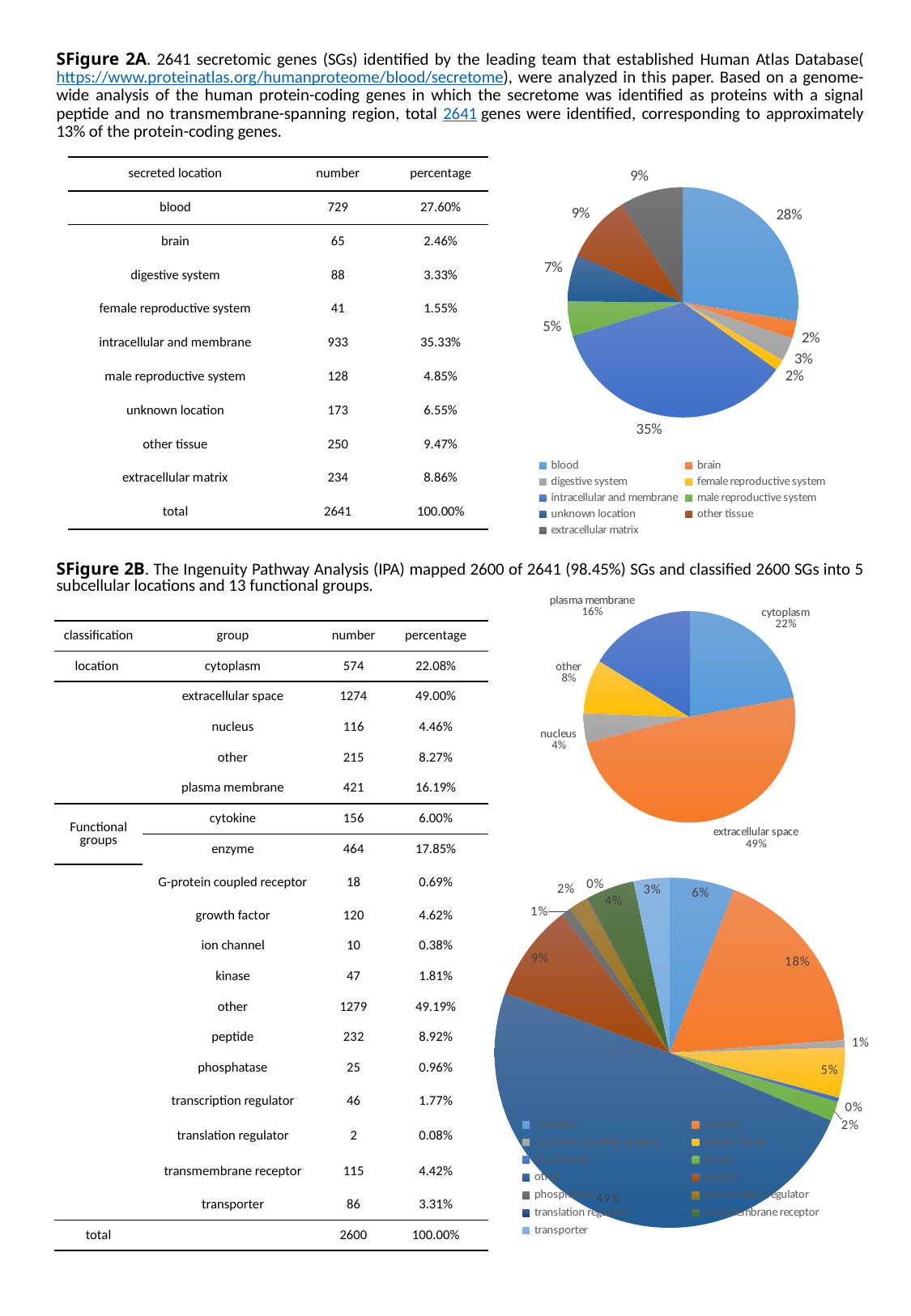
In the SFigure 2B subcellular location pie chart, what is the difference in percentage points between extracellular space and cytoplasm? 27% In the SFigure 2B subcellular location pie chart, what percentage is shown for plasma membrane? 16% What kind of chart is shown in SFigure 2A? pie chart In the SFigure 2A pie chart, what percentage is shown for intracellular and membrane? 35% In the SFigure 2B subcellular location pie chart, which location has the smallest slice? nucleus In the SFigure 2A pie chart, what percentage is shown for blood? 28% How many slices are in the SFigure 2B subcellular location pie chart? 5 In the SFigure 2A pie chart, which is larger: unknown location or male reproductive system? unknown location In the SFigure 2B functional groups pie chart (bottom), what percentage is labelled on the largest slice? 49% How many categories does the legend of the SFigure 2A pie chart list? 9 In the SFigure 2A pie chart, which secreted location has the largest slice? intracellular and membrane In the SFigure 2B subcellular location pie chart, what percentage is shown for extracellular space? 49%